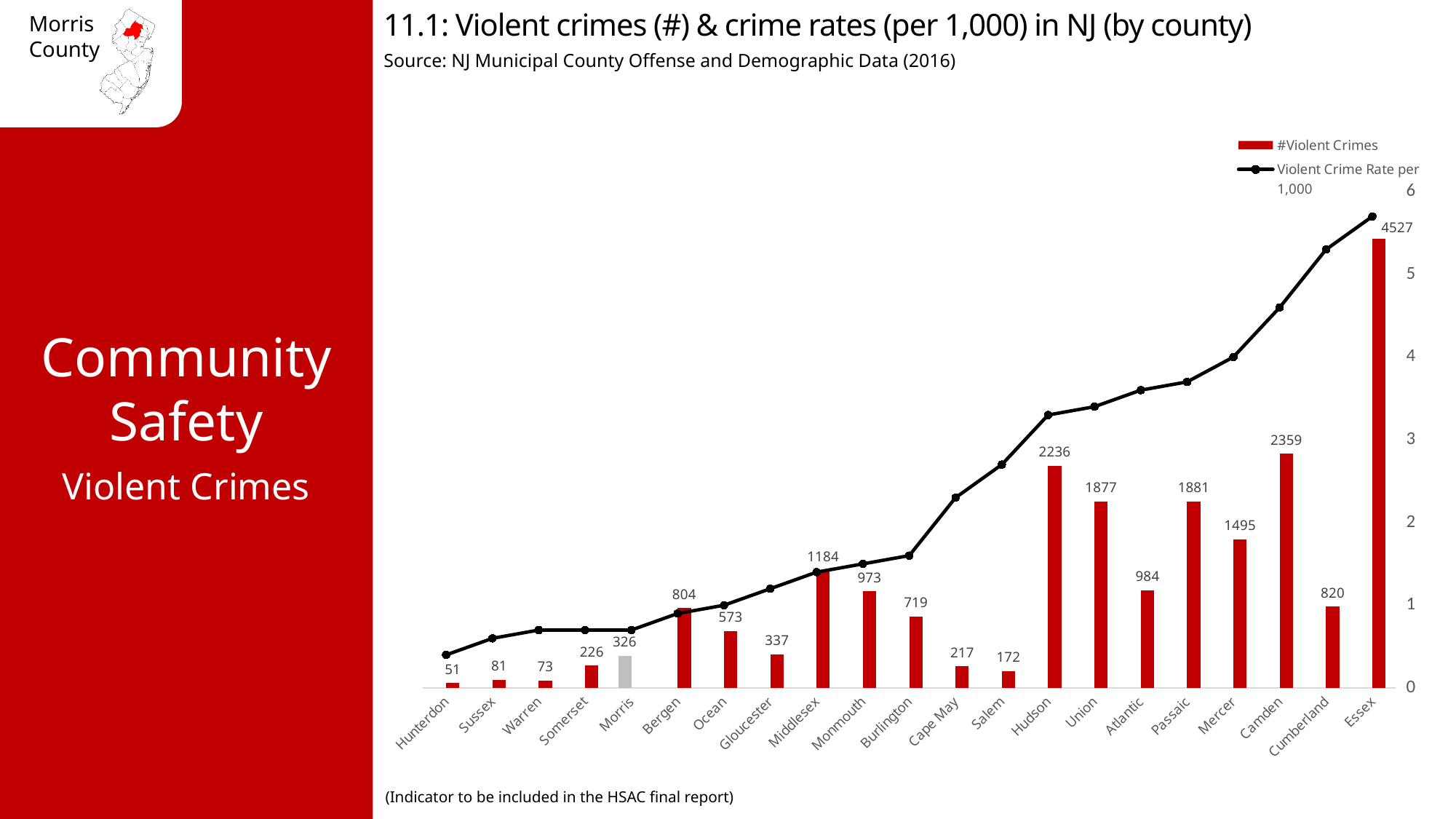
How many counties are shown on the x axis of the chart? 21 What is the number of violent crimes for Morris County? 326 What is the difference in the number of violent crimes between Camden and Hudson? 123 What is the number of violent crimes for Essex County? 4527 Which county has the lowest number of violent crimes? Hunterdon Does the violent crime rate per 1,000 line generally rise or fall from left to right across the counties? Rise What kind of chart is shown on the slide? A combination bar and line chart Which county has more violent crimes, Middlesex or Mercer? Mercer Is the violent crime rate per 1,000 for Essex greater or less than 5? greater Is the violent crime rate per 1,000 for Hunterdon greater or less than 1? less Which county has the highest number of violent crimes? Essex How many series does the chart legend list? 2